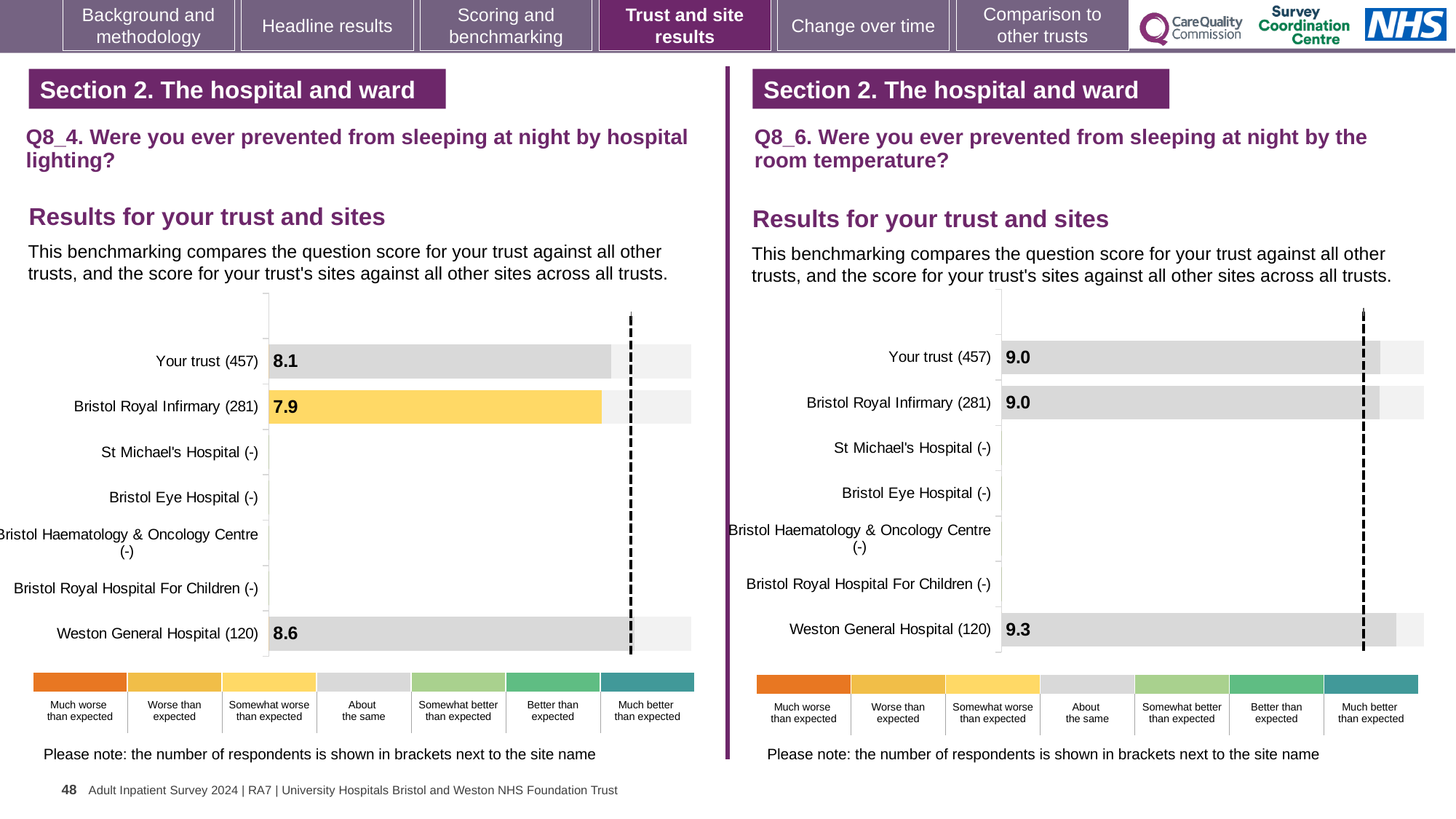
In the Q8_4 hospital lighting chart, which site has the highest score? Weston General Hospital (120) In the Q8_4 hospital lighting chart, what is the difference between the scores for Weston General Hospital (120) and Bristol Royal Infirmary (281)? 0.7 What kind of chart is used for the Q8_4 hospital lighting results? Bar chart In the Q8_6 room temperature chart, what is the score for Weston General Hospital (120)? 9.3 In the Q8_6 room temperature chart, what is the score for Your trust (457)? 9.0 In the Q8_4 hospital lighting chart, which benchmark category does the Bristol Royal Infirmary bar's colour correspond to? Somewhat worse than expected In the Q8_4 hospital lighting chart, what is the score for Your trust (457)? 8.1 How many site/trust categories are listed on the y axis of the Q8_6 room temperature chart? 7 In the Q8_4 hospital lighting chart, what is the score for Bristol Royal Infirmary (281)? 7.9 In the Q8_4 hospital lighting chart, which labelled bar has the lowest score? Bristol Royal Infirmary (281) In the Q8_6 room temperature chart, which site has the highest score? Weston General Hospital (120) In the Q8_6 room temperature chart, what is the difference between the scores for Weston General Hospital (120) and Bristol Royal Infirmary (281)? 0.3